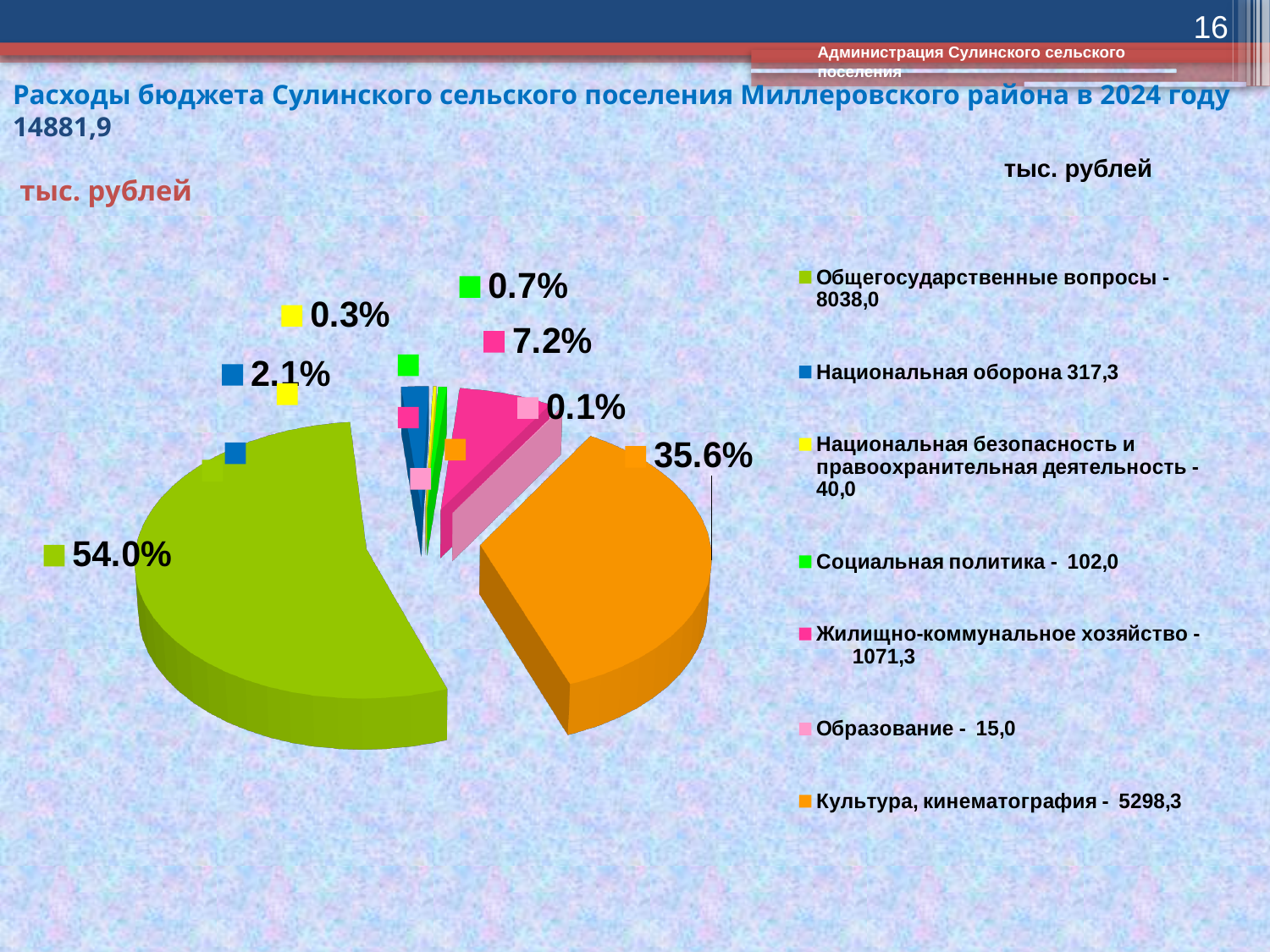
What share of the pie does Культура, кинематография take? 35.6% What kind of chart is shown on the slide? pie chart What value (тыс. рублей) does the legend give for Культура, кинематография? 5298,3 Which is larger: the slice for Национальная оборона or the slice for Социальная политика? Национальная оборона What share of the pie does Жилищно-коммунальное хозяйство take? 7.2% How many slices does the pie chart have? 7 Which category has the largest slice of the pie? Общегосударственные вопросы What is the difference in percentage points between the Общегосударственные вопросы slice and the Культура, кинематография slice? 18.4% What share of the pie does Общегосударственные вопросы take? 54.0% What value (тыс. рублей) does the legend give for Национальная оборона? 317,3 What colour is the slice for Жилищно-коммунальное хозяйство? pink Which category has the smallest slice of the pie? Образование